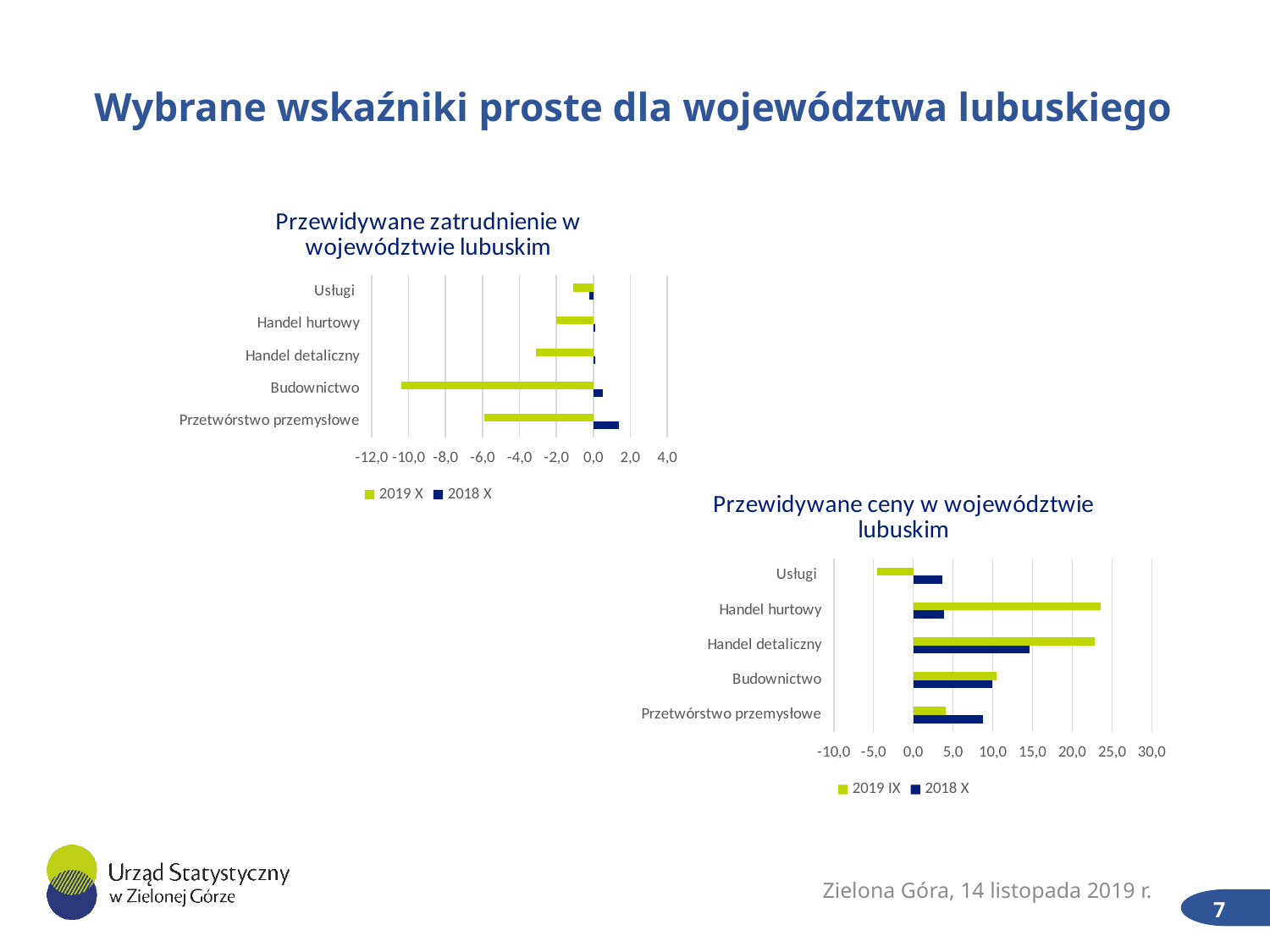
In the "Przewidywane zatrudnienie w województwie lubuskim" chart, which category has the lowest 2019 X value? Budownictwo How many series does the legend of the "Przewidywane zatrudnienie w województwie lubuskim" chart list? 2 How many categories are shown in the "Przewidywane ceny w województwie lubuskim" chart? 5 In the "Przewidywane ceny w województwie lubuskim" chart, which category has the highest 2018 X value? Handel detaliczny What are the legend entries of the "Przewidywane ceny w województwie lubuskim" chart? 2019 IX and 2018 X What kind of chart is "Przewidywane zatrudnienie w województwie lubuskim"? bar chart In the "Przewidywane ceny w województwie lubuskim" chart, for Przetwórstwo przemysłowe, which series has the larger value, 2019 IX or 2018 X? 2018 X In the "Przewidywane zatrudnienie w województwie lubuskim" chart, which category has the highest 2018 X value? Przetwórstwo przemysłowe In the "Przewidywane zatrudnienie w województwie lubuskim" chart, is the 2019 X value for Budownictwo greater or less than -8,0? less In the "Przewidywane zatrudnienie w województwie lubuskim" chart, is the 2019 X value for Przetwórstwo przemysłowe greater or less than -4,0? less In the "Przewidywane ceny w województwie lubuskim" chart, which category has the lowest 2019 IX value? Usługi In the "Przewidywane ceny w województwie lubuskim" chart, is the 2019 IX value for Handel hurtowy greater or less than 20,0? greater